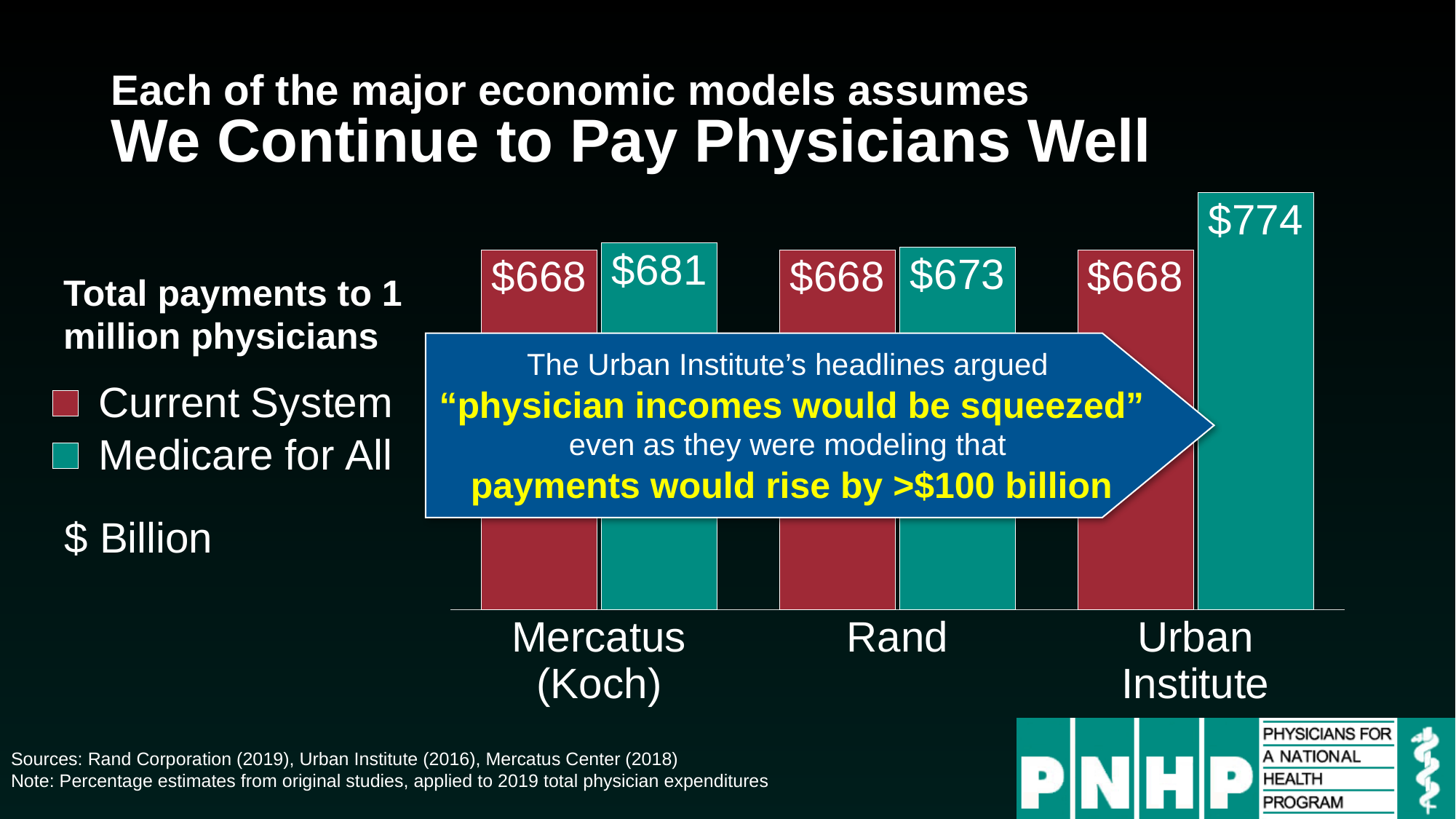
Which category has the lowest Medicare for All value? Rand Which is larger for Rand: the Current System value or the Medicare for All value? Medicare for All What is the Current System value for Rand? $668 Which category has the highest Medicare for All value? Urban Institute What is the difference between the Medicare for All and Current System values for the Urban Institute? $106 What is the Medicare for All value for Rand? $673 How many categories are shown on the x axis? 3 What kind of chart is shown on the slide? Bar chart How many series does the legend list? 2 What is the Medicare for All value for the Urban Institute? $774 What is the Medicare for All value for Mercatus (Koch)? $681 What is the difference between the Medicare for All values for Mercatus (Koch) and Rand? $8